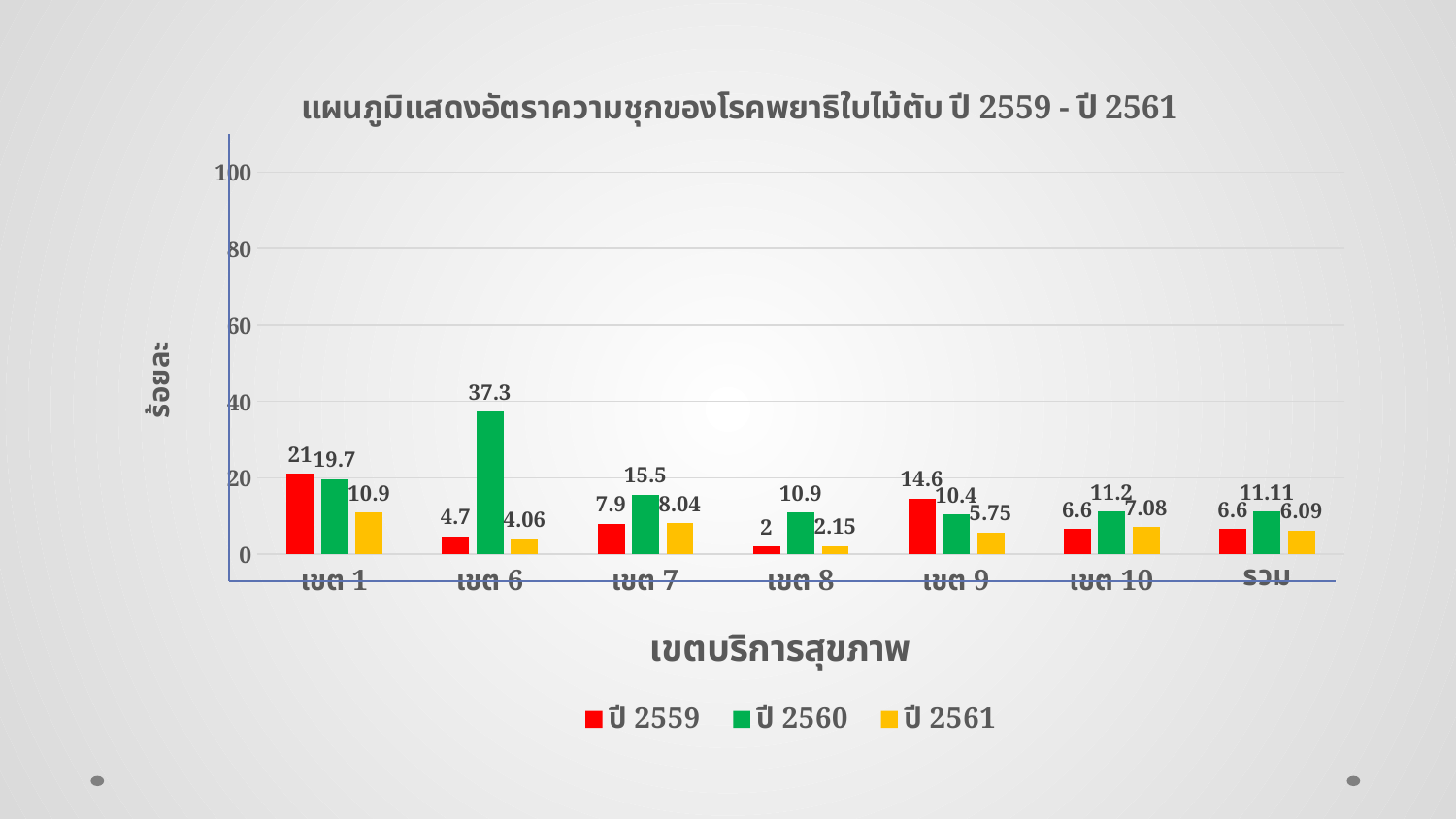
Which category has the highest value for ปี 2560? เขต 6 Is the value for ปี 2560 in เขต 6 greater or less than 40? less What colour represents ปี 2561 in the chart? yellow What is the difference between the ปี 2559 and ปี 2560 values in เขต 9? 4.2 How many series does the legend list? 3 What is the value for ปี 2561 in รวม? 6.09 What kind of chart is shown on the slide? bar chart What is the value for ปี 2560 in เขต 6? 37.3 Which category has the lowest value for ปี 2559? เขต 8 What is the value for ปี 2559 in เขต 1? 21 Which is larger in เขต 7: the value for ปี 2559 or the value for ปี 2560? ปี 2560 How many categories are shown on the x axis? 7